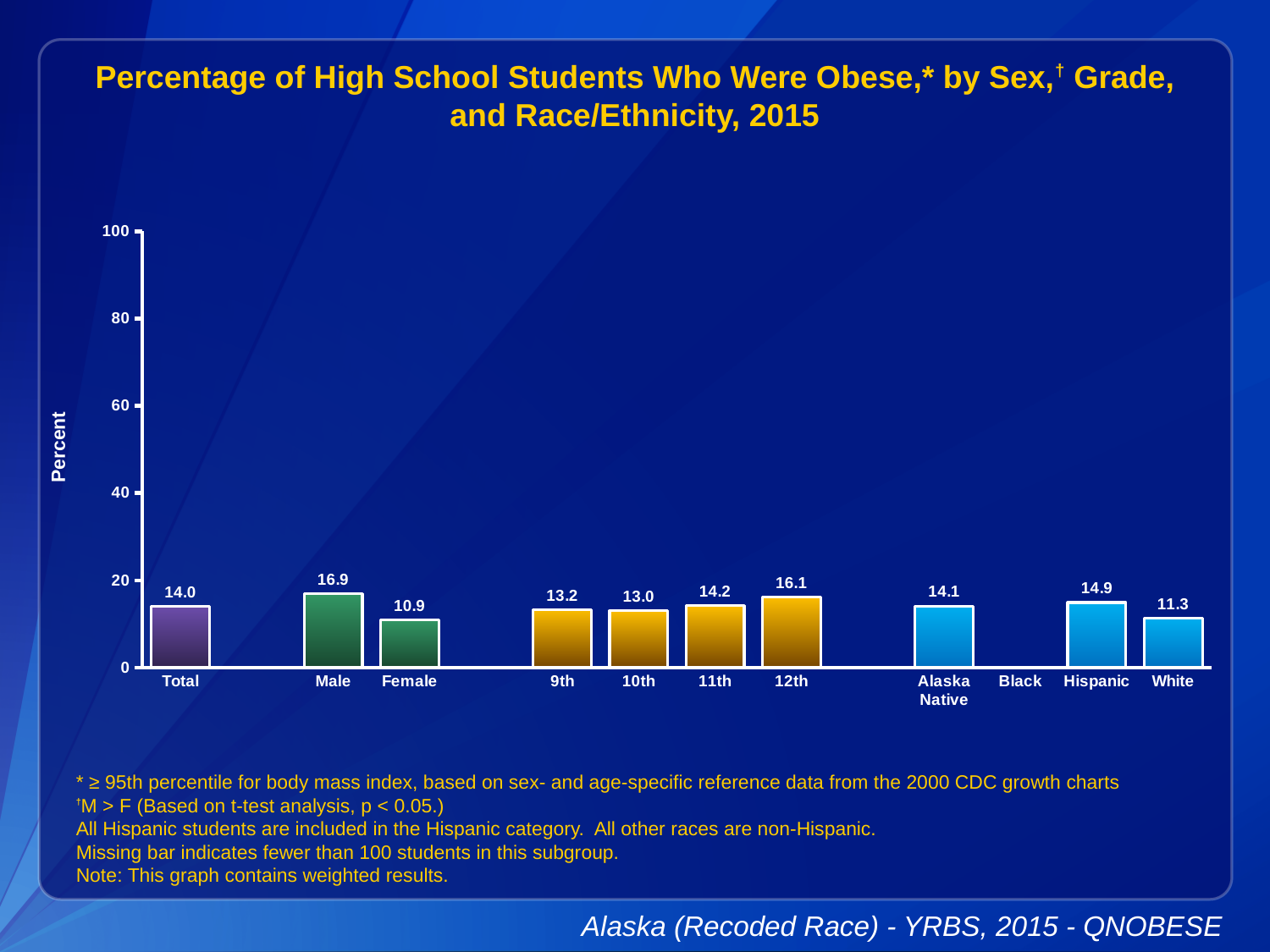
Which category has the highest value on the chart? Male Which category has the lowest value among the bars shown? Female Is the value for Alaska Native students greater or less than 20? less Which race/ethnicity category has no bar shown? Black How many categories are labeled on the x axis? 11 What is the value for Hispanic students? 14.9 Which is larger, the value for 9th grade or the value for 11th grade? 11th What is the value for 12th grade students? 16.1 What is the difference between the Male and Female values? 6.0 What kind of chart is shown on the slide? bar chart What is the value for Male students? 16.9 What is the percentage of high school students who were obese for the Total category? 14.0